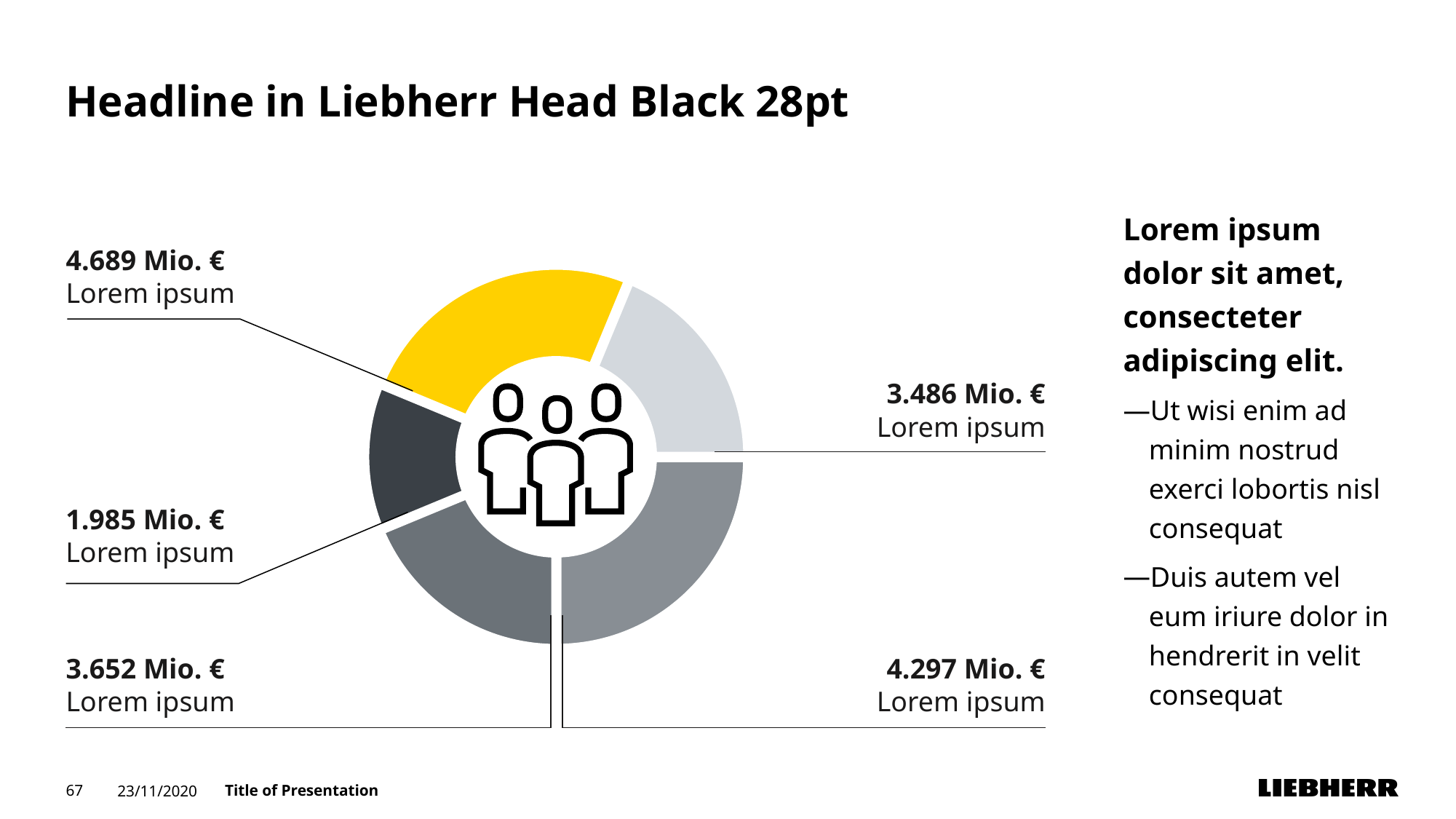
What is the value of the light grey segment on the upper right of the donut chart? 3.486 Mio. € What is the value of the darkest segment on the left of the donut chart? 1.985 Mio. € What is the value of the yellow segment of the donut chart? 4.689 Mio. € What is the difference between the largest segment (4.689 Mio. €) and the smallest segment (1.985 Mio. €)? 2.704 Mio. € Which is larger: the yellow segment or the light grey segment on the upper right? The yellow segment What kind of chart is shown on the slide? Donut (pie) chart Which value is the largest among the segments of the donut chart? 4.689 Mio. € What is the total of all five segment values in the donut chart? 18.109 Mio. € What is the value of the segment at the bottom right of the donut chart? 4.297 Mio. € Which value is the smallest among the segments of the donut chart? 1.985 Mio. € How many segments does the donut chart have? 5